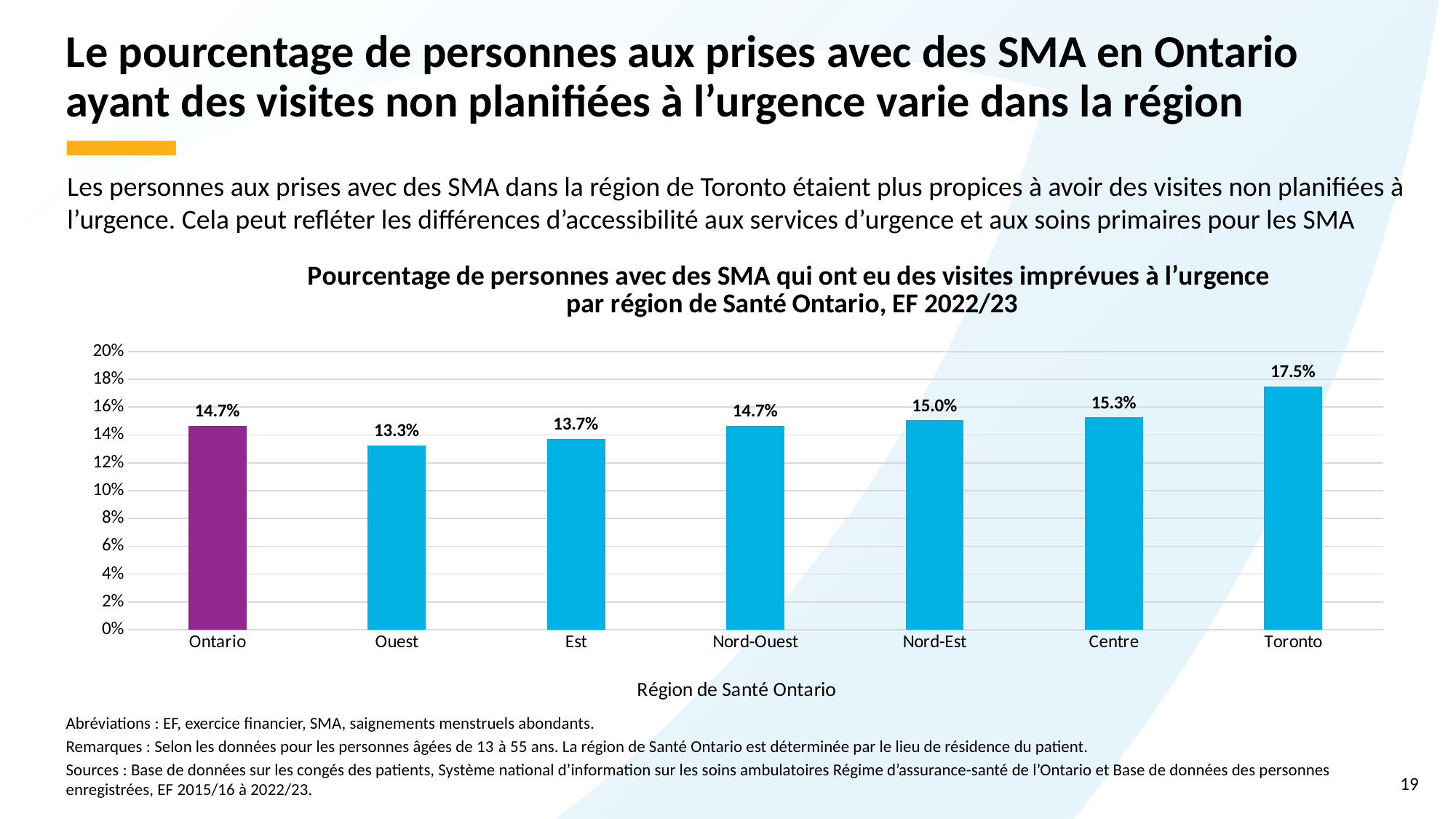
What is the label of the x axis? Région de Santé Ontario Which is larger, the value for Centre or the value for Est? Centre What is the value for Nord-Est? 15.0% What is the value for Ontario? 14.7% Which region has the lowest percentage? Ouest Which region has the highest percentage? Toronto What is the value for Toronto? 17.5% What is the value for Ouest? 13.3% How many categories are shown on the x axis? 7 Is the value for Toronto greater or less than 16%? greater What is the difference between the values for Toronto and Ouest? 4.2% What kind of chart is shown on the slide? Bar chart